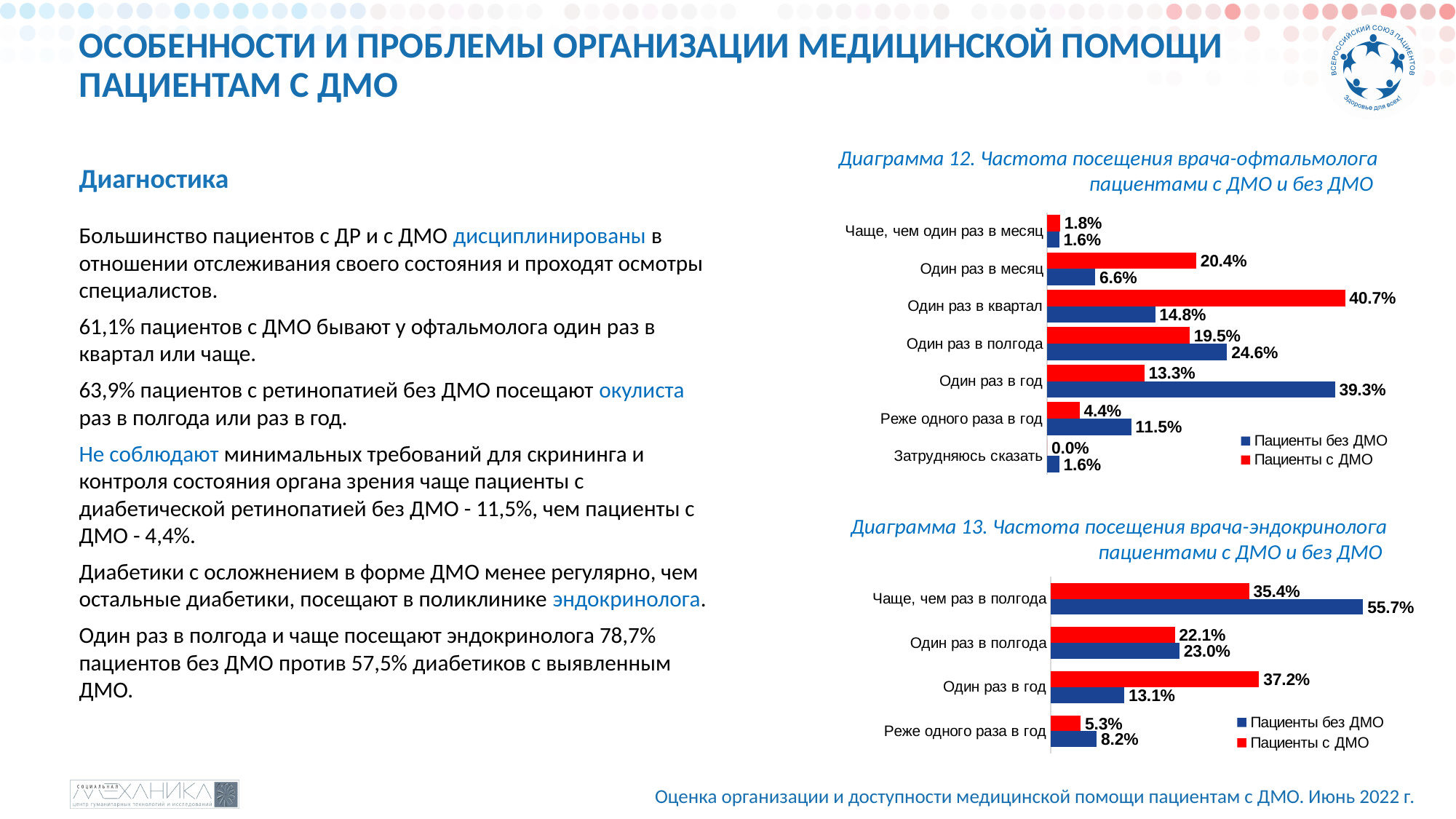
What type of chart is Диаграмма 12? Bar chart In Диаграмма 13, what is the value for 'Пациенты без ДМО' in the category 'Чаще, чем раз в полгода'? 55.7% How many series does the legend of Диаграмма 13 list? 2 In Диаграмма 12, what is the difference between 'Пациенты с ДМО' and 'Пациенты без ДМО' in the category 'Один раз в месяц'? 13.8% In Диаграмма 13, what is the value for 'Пациенты с ДМО' in the category 'Один раз в год'? 37.2% In Диаграмма 13, which category has the lowest value for 'Пациенты без ДМО'? Реже одного раза в год In Диаграмма 12, how many categories are shown on the vertical axis? 7 In Диаграмма 12, what is the value for 'Пациенты без ДМО' in the category 'Один раз в год'? 39.3% In Диаграмма 12, which category has the highest value for 'Пациенты с ДМО'? Один раз в квартал In Диаграмма 12, which category has the lowest value for 'Пациенты с ДМО'? Затрудняюсь сказать In Диаграмма 12, what is the value for 'Пациенты с ДМО' in the category 'Один раз в квартал'? 40.7% In Диаграмма 13, which is larger in the category 'Реже одного раза в год': 'Пациенты с ДМО' or 'Пациенты без ДМО'? Пациенты без ДМО